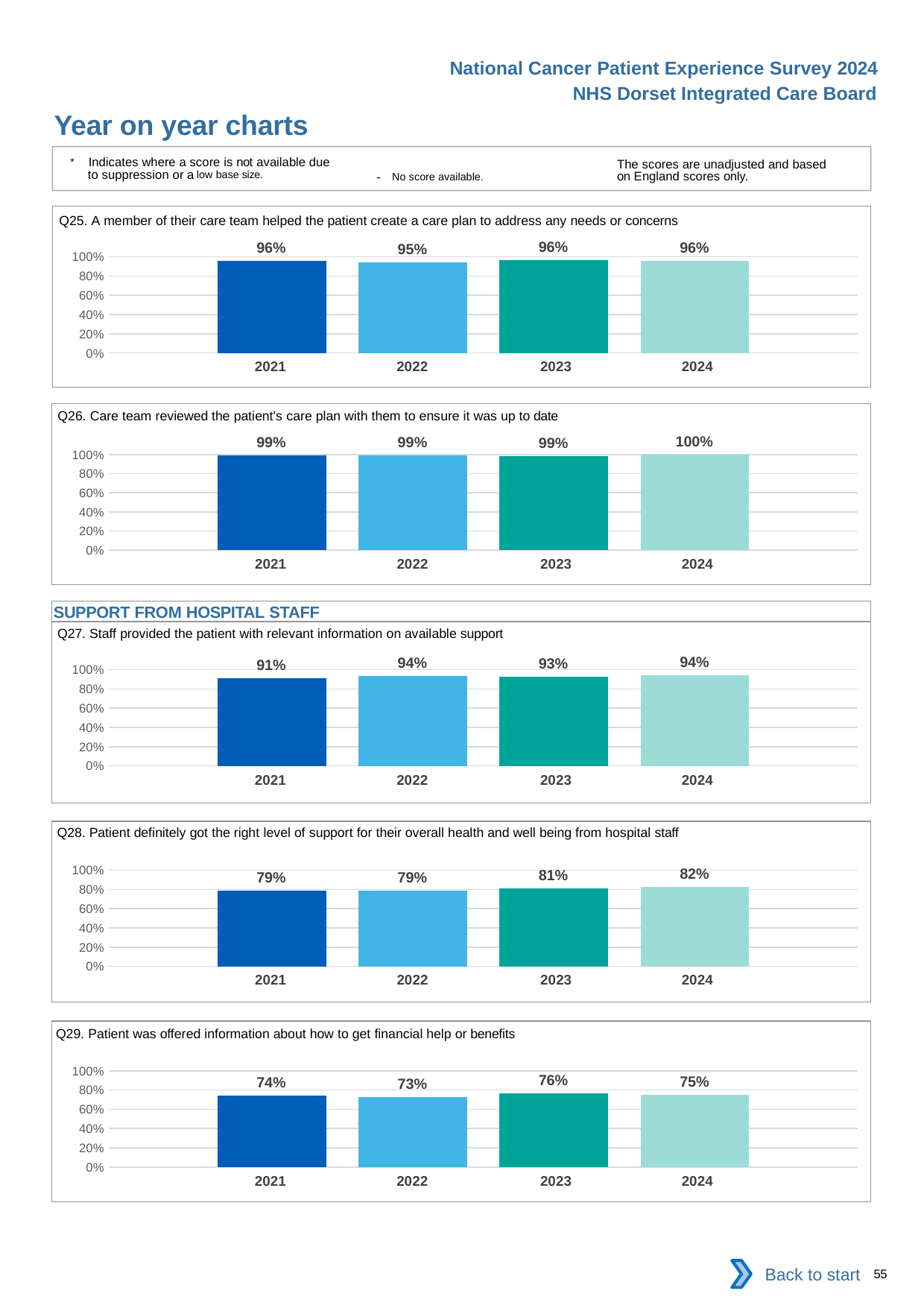
In the Q29 chart, which is larger, the value for 2023 or the value for 2022? 2023 In the Q27 chart, what is the difference between the 2022 value and the 2021 value? 3% In the Q29 chart, is the value for 2024 greater or less than 80%? less In the Q28 chart, what is the difference between the 2024 value and the 2021 value? 3% In the Q26 chart, what is the value for 2024? 100% In the Q28 chart, do the values rise or fall from 2022 to 2024? rise In the Q26 chart, which year has the highest value? 2024 What kind of chart is the Q27 chart? bar chart In the Q27 chart, which year has the lowest value? 2021 How many years are shown in the Q28 chart? 4 What is the section heading shown above the Q27 chart? SUPPORT FROM HOSPITAL STAFF In the Q25 chart, what is the value for 2022? 95%